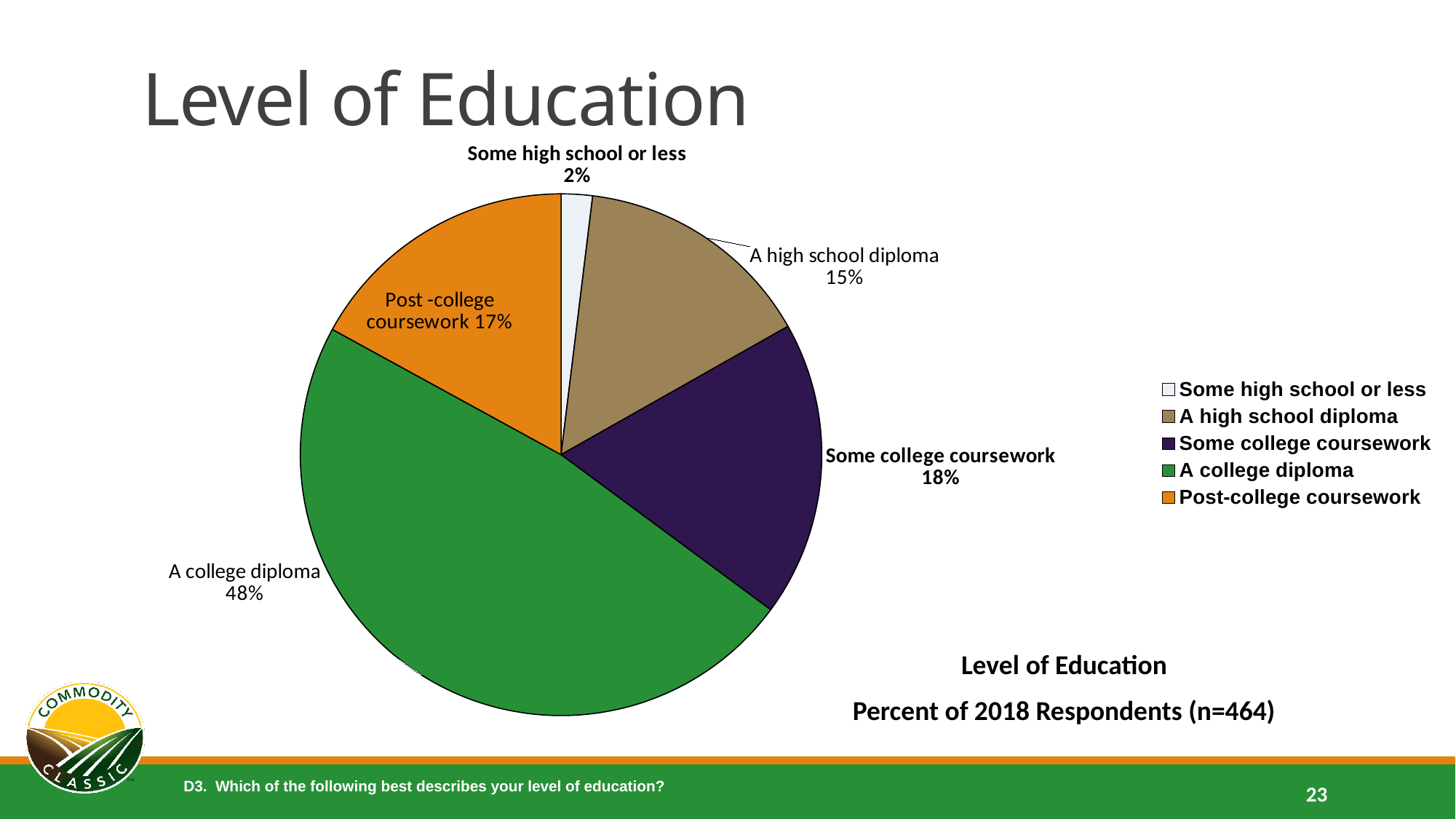
How many categories are shown in the pie chart? 5 What percentage of respondents have some college coursework? 18% Which level of education has the largest share of respondents? A college diploma How many respondents (n) does the chart caption say were surveyed in 2018? 464 What percentage of respondents have post-college coursework? 17% What is the combined share of 'A high school diploma' and 'Post-college coursework'? 32% What percentage of respondents have a college diploma? 48% What kind of chart is shown on the slide? Pie chart Which level of education has the smallest share of respondents? Some high school or less Which is larger: the share for 'A high school diploma' or 'Some college coursework'? Some college coursework What percentage of respondents have some high school or less? 2% What is the difference in percentage points between 'A college diploma' and 'Some college coursework'? 30